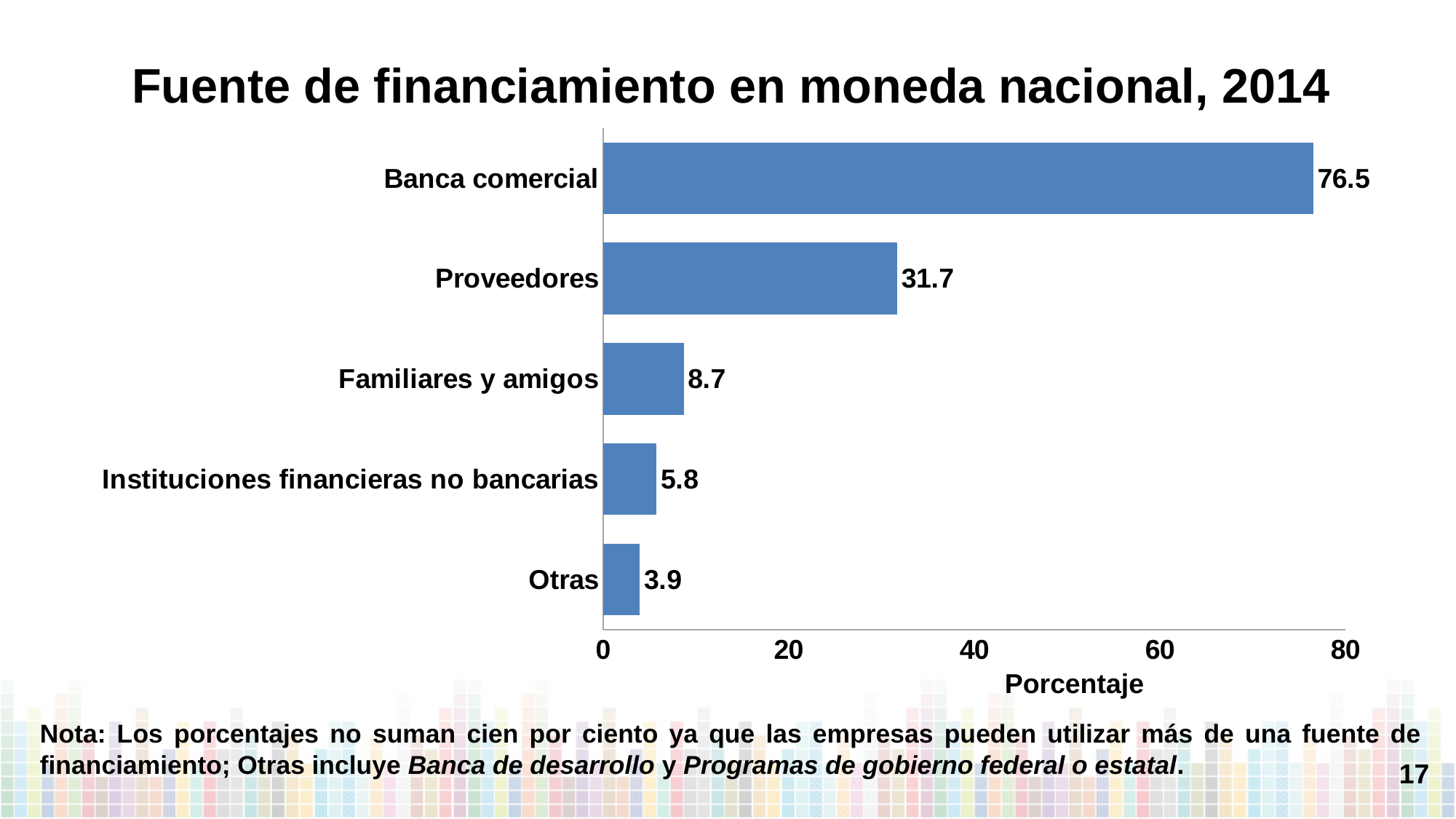
What is the value for Banca comercial? 76.5 What is the value for Instituciones financieras no bancarias? 5.8 What is the value for Proveedores? 31.7 Which category has the lowest value? Otras What kind of chart is shown on the slide? bar chart What is the value for Familiares y amigos? 8.7 Is the value for Proveedores greater or less than 40? less What is the difference between the values for Banca comercial and Proveedores? 44.8 Which category has the highest value? Banca comercial Which is larger, the value for Familiares y amigos or the value for Instituciones financieras no bancarias? Familiares y amigos What is the label of the horizontal axis? Porcentaje How many categories are shown in the chart? 5